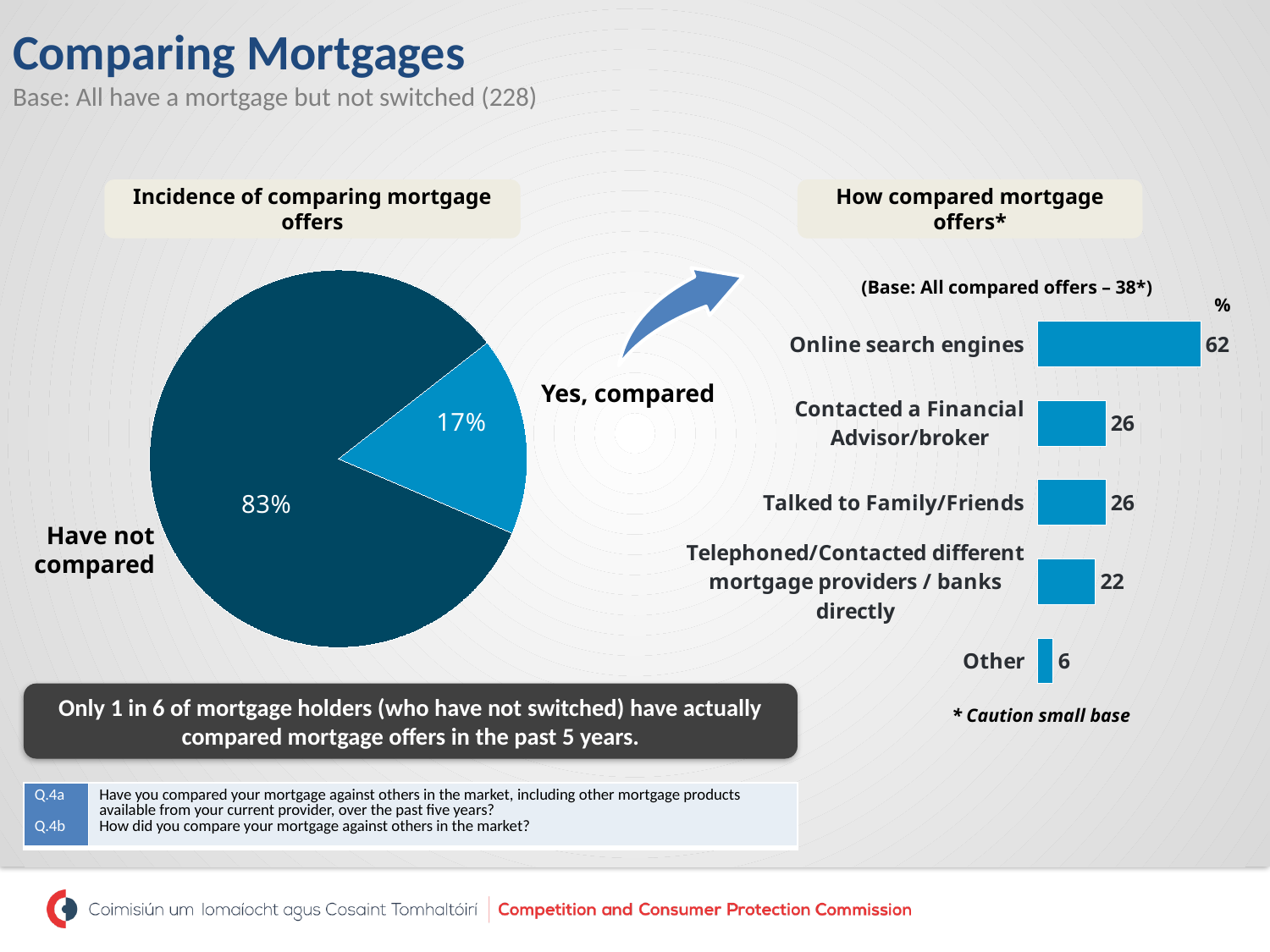
What base is stated for the 'How compared mortgage offers' chart? All compared offers – 38* In the 'How compared mortgage offers' chart, which category has the highest value? Online search engines In the 'How compared mortgage offers' chart, what is the value for Telephoned/Contacted different mortgage providers / banks directly? 22 In the 'Incidence of comparing mortgage offers' pie chart, what percentage have not compared? 83% How many categories are shown in the 'How compared mortgage offers' bar chart? 5 In the 'How compared mortgage offers' chart, what is the difference between Online search engines and Contacted a Financial Advisor/broker? 36 In the 'How compared mortgage offers' chart, what is the value for Online search engines? 62 What type of chart is the 'Incidence of comparing mortgage offers' chart? pie chart In the 'How compared mortgage offers' chart, which category has the lowest value? Other In the 'Incidence of comparing mortgage offers' pie chart, what percentage said 'Yes, compared'? 17% In the 'How compared mortgage offers' chart, which is larger: Talked to Family/Friends or Other? Talked to Family/Friends What type of chart is the 'How compared mortgage offers' chart? bar chart